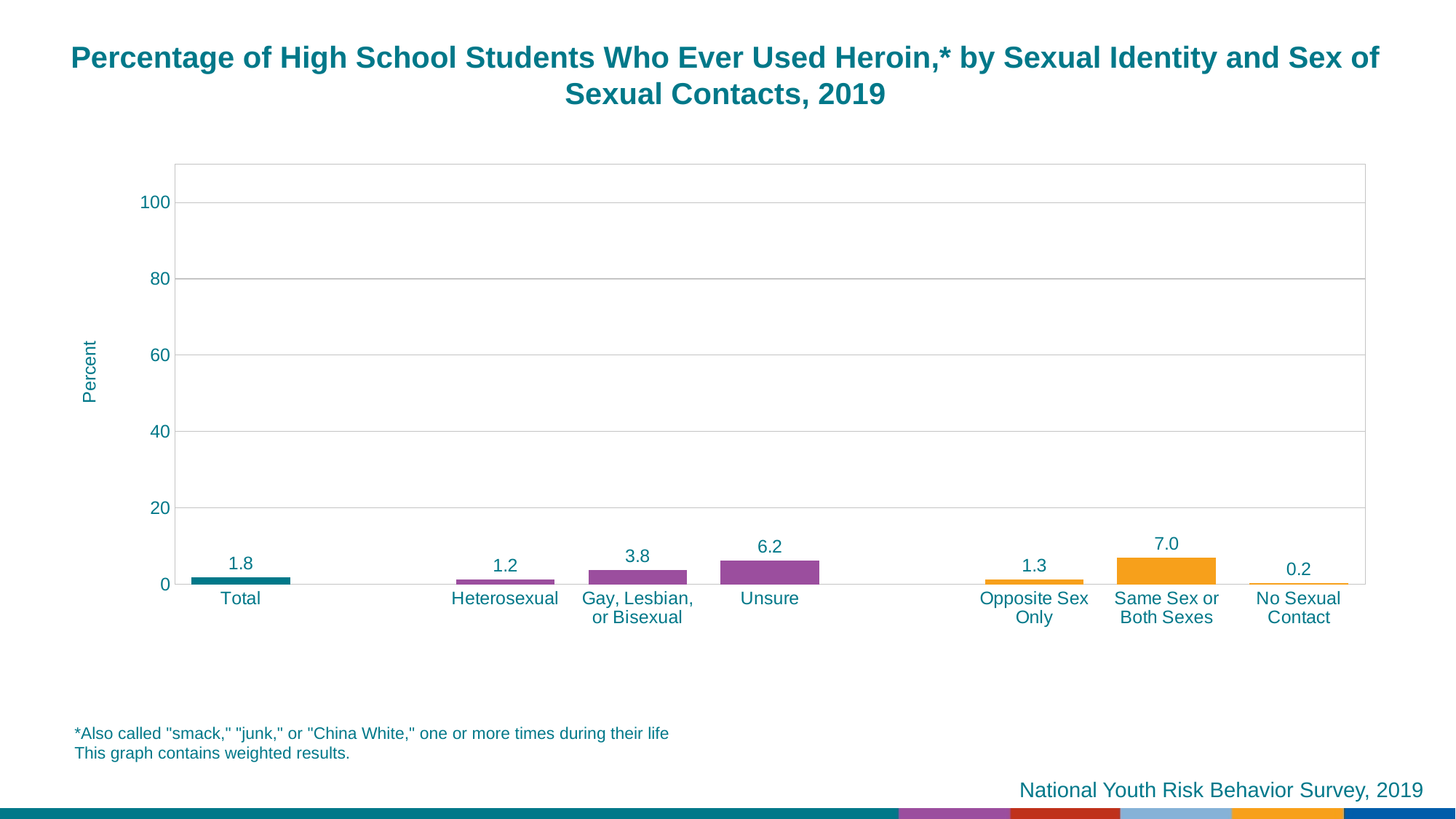
What is the value for Same Sex or Both Sexes? 7.0 What is the value for Total? 1.8 Which category has the highest value? Same Sex or Both Sexes Which is larger, the value for Gay, Lesbian, or Bisexual or the value for Opposite Sex Only? Gay, Lesbian, or Bisexual What is the value for Unsure? 6.2 What is the value for Heterosexual? 1.2 What kind of chart is shown on the slide? bar chart What is the label of the y axis? Percent Which category has the lowest value? No Sexual Contact How many categories are shown on the chart? 7 Is the value for Same Sex or Both Sexes greater or less than 20? less What is the difference between the values for Unsure and Heterosexual? 5.0